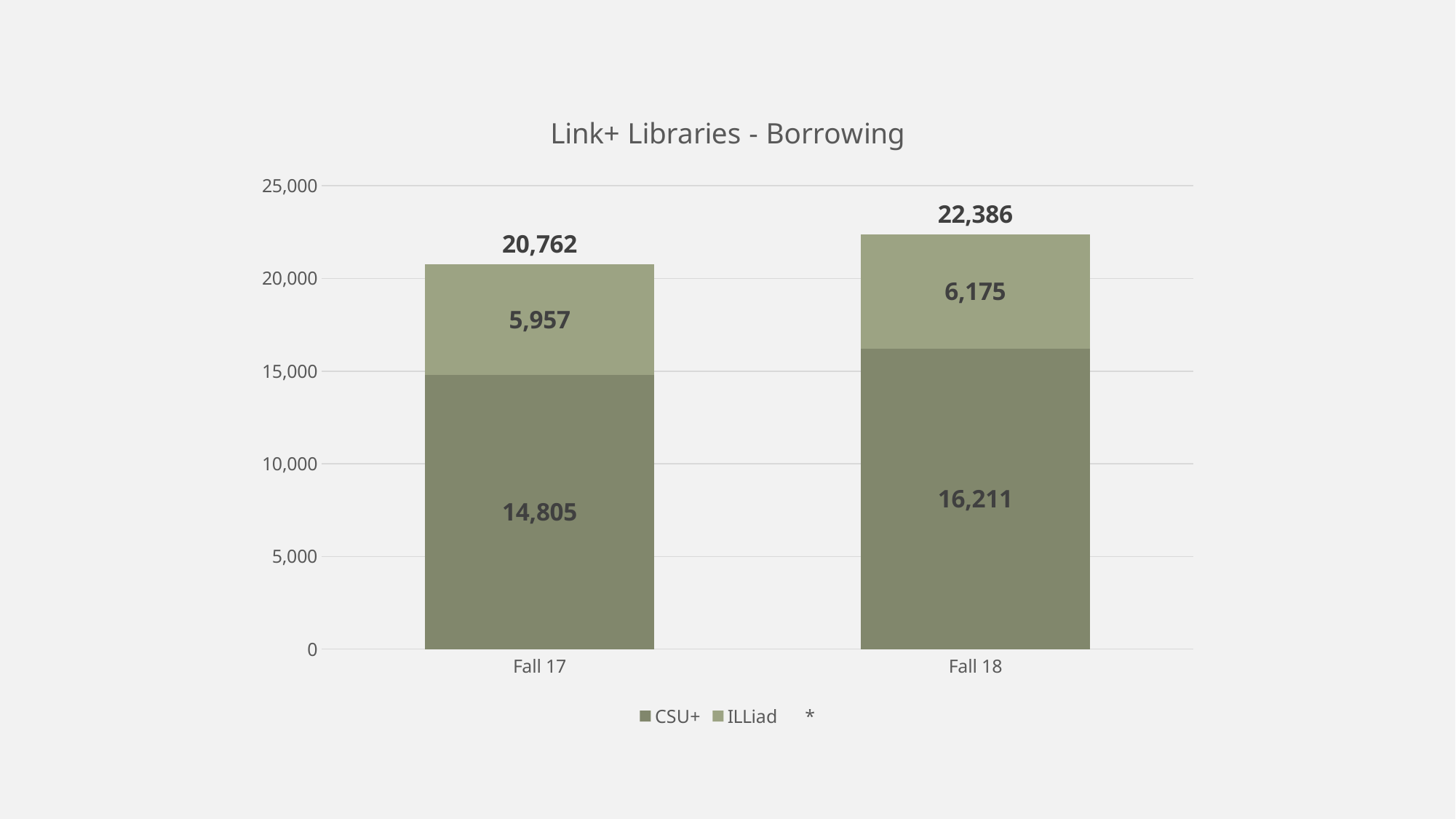
What is the ILLiad value for Fall 17? 5,957 How many series does the legend list? 3 Which period has the higher total borrowing, Fall 17 or Fall 18? Fall 18 What is the total of the stacked bar for Fall 17? 20,762 What is the ILLiad value for Fall 18? 6,175 How many categories are shown on the x axis? 2 What is the difference between the CSU+ values for Fall 18 and Fall 17? 1,406 What is the CSU+ value for Fall 17? 14,805 What is the total of the stacked bar for Fall 18? 22,386 Is the CSU+ value for Fall 18 greater or less than 15,000? greater What is the CSU+ value for Fall 18? 16,211 What kind of chart is shown on the slide? Stacked bar chart